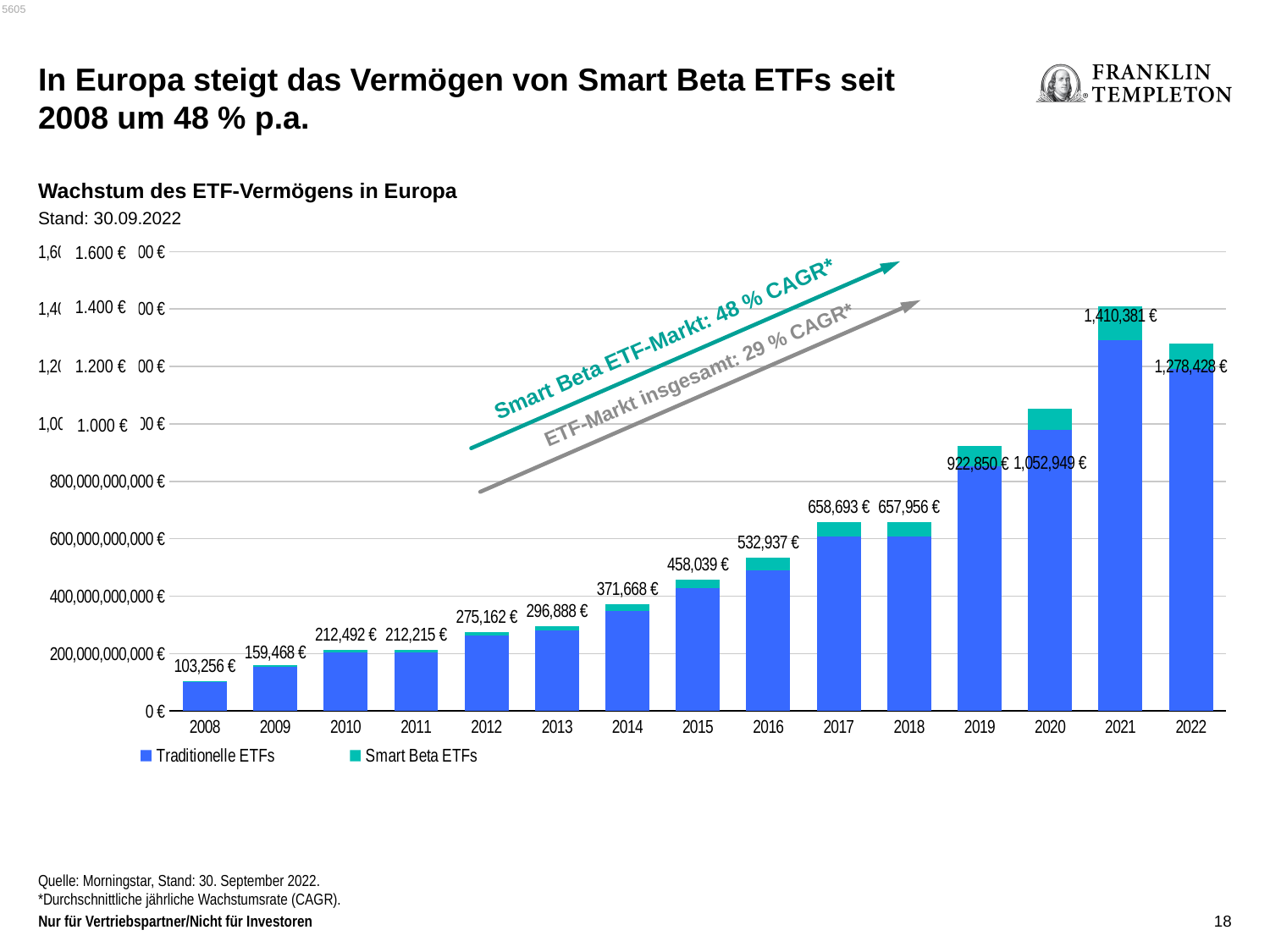
What kind of chart is shown on the slide? Stacked bar chart How many years are shown on the x axis of the chart? 15 What total value is labelled for 2008? 103,256 € Which year has the lowest labelled total? 2008 What is the difference between the labelled totals for 2021 and 2022? 131,953 € What CAGR does the annotation give for the Smart Beta ETF market? 48 % Which year has the larger labelled total, 2019 or 2020? 2020 What total value is labelled for 2021? 1,410,381 € What total value is labelled for 2016? 532,937 € Is the total bar for 2019 greater or less than 800,000,000,000 € on the axis? greater Which year has the highest labelled total? 2021 How many series does the legend list? 2